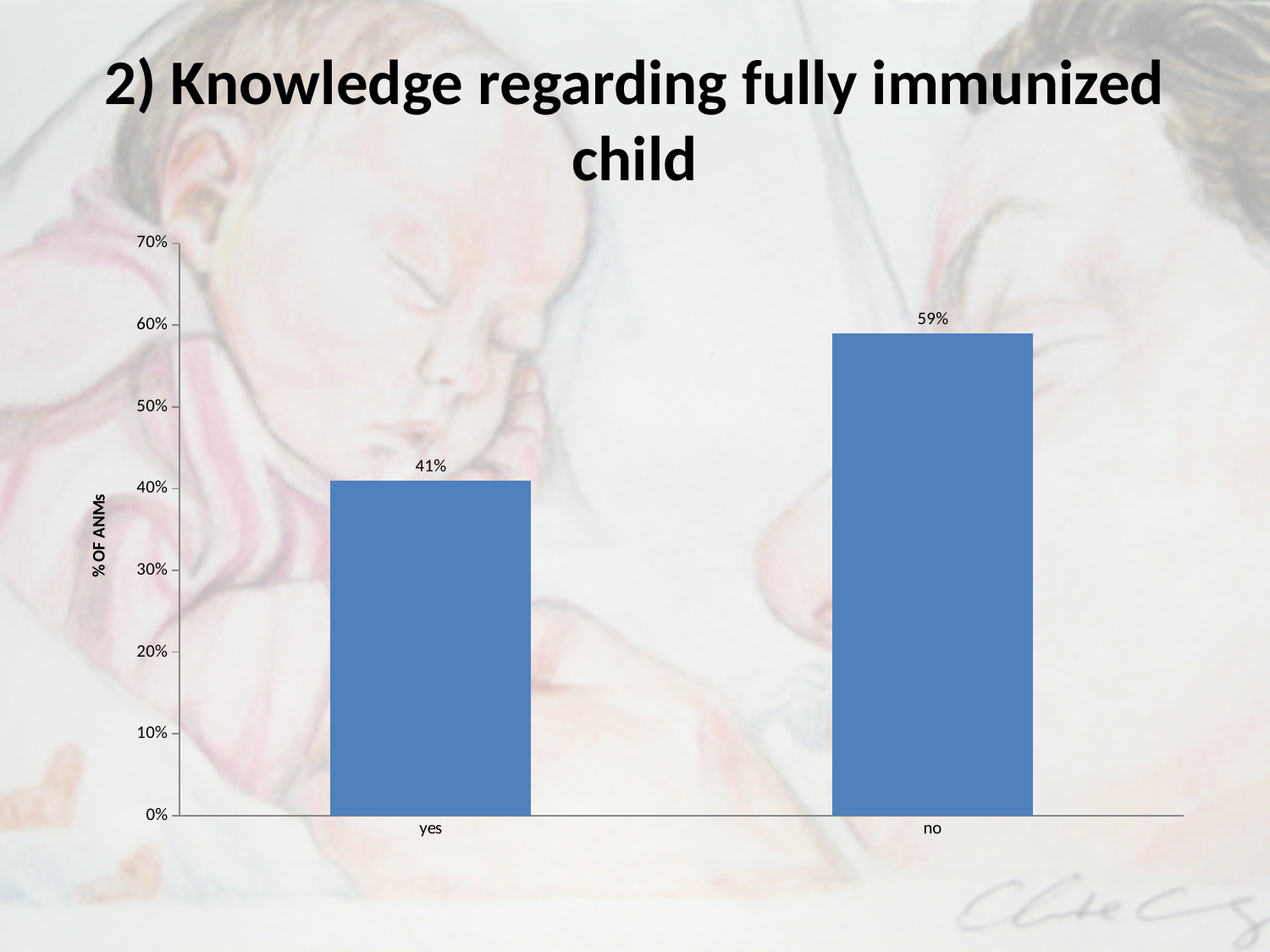
What is the difference between the "no" and "yes" percentages? 18% How many categories are shown on the x axis? 2 Is the value for "yes" greater or less than 50%? less Which category has the lowest value on the chart? yes What percentage of ANMs answered "yes" regarding knowledge of a fully immunized child? 41% What percentage of ANMs answered "no" regarding knowledge of a fully immunized child? 59% What kind of chart is shown on the slide? bar chart What is the title of the slide? 2) Knowledge regarding fully immunized child Is the value for "yes" larger or smaller than the value for "no"? smaller Which category has the higher value, "yes" or "no"? no What is the label of the vertical axis? % OF ANMs Is the value for "no" greater or less than 50%? greater